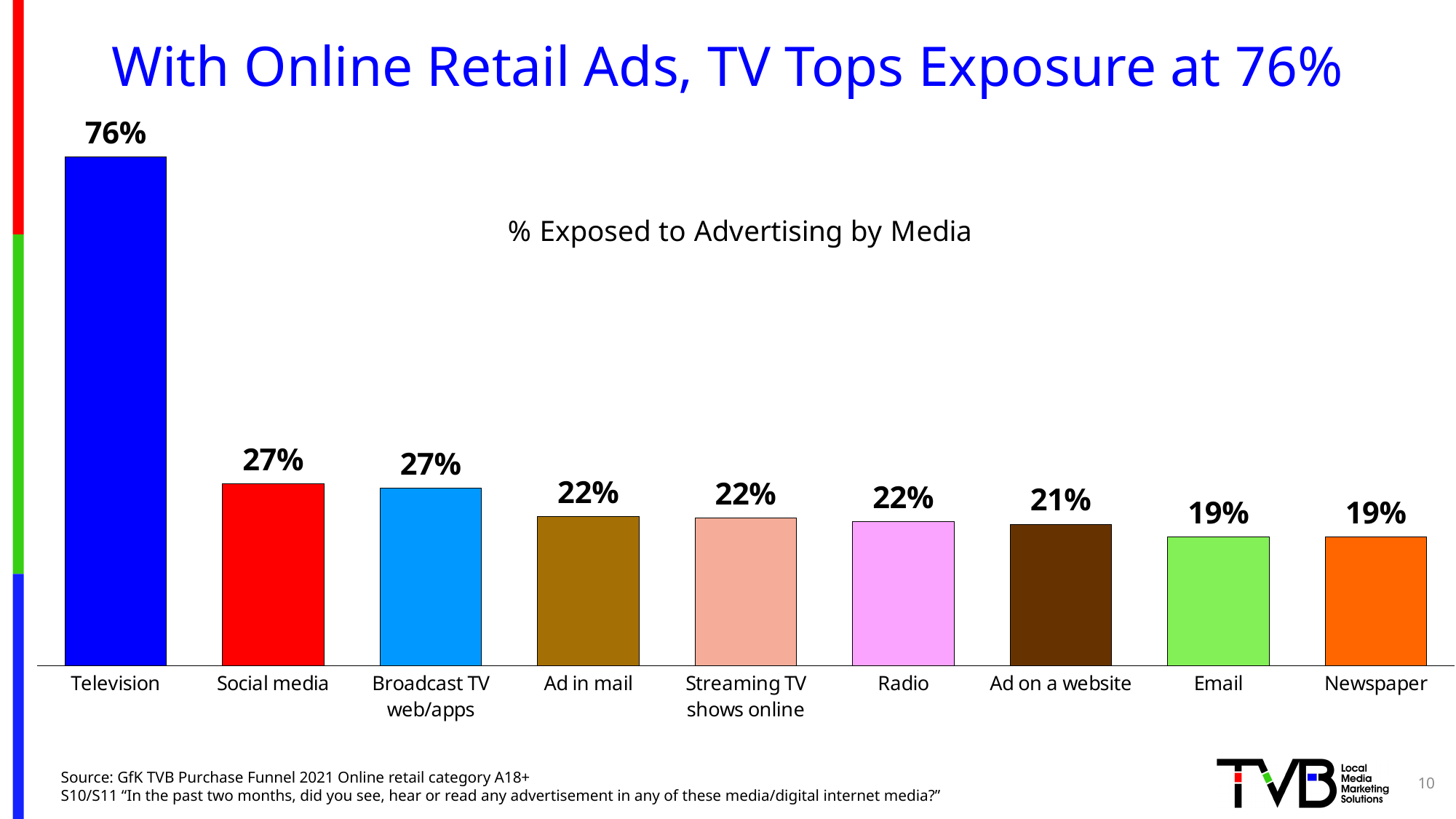
What is the difference between the values for Radio and Email? 3% What is the difference between the values for Television and Social media? 49% Which is larger, the value for Social media or the value for Newspaper? Social media Which category has the highest value? Television What is the value for Television? 76% How many categories are shown on the chart? 9 What is the value for Streaming TV shows online? 22% What kind of chart is shown on the slide? bar chart What is the value for Ad on a website? 21% What colour is the bar for Television? blue What is the title of the chart? % Exposed to Advertising by Media Do the values generally rise or fall from left to right along the x axis? fall